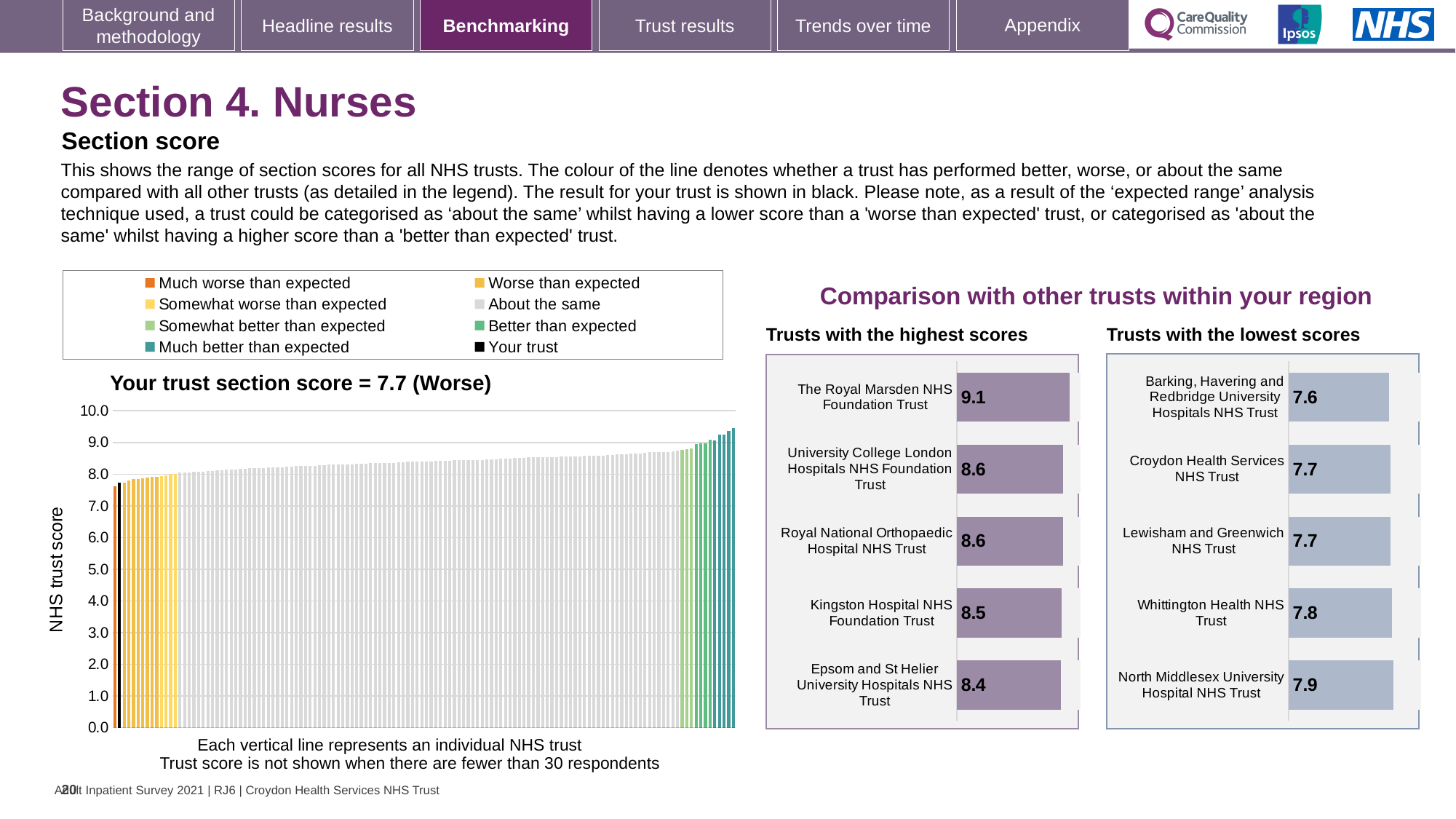
In the 'Trusts with the lowest scores' chart, which has the higher score, Whittington Health NHS Trust or Barking, Havering and Redbridge University Hospitals NHS Trust? Whittington Health NHS Trust In the 'Trusts with the lowest scores' chart, how many trusts are shown? 5 In the 'Trusts with the highest scores' chart, what is the score for The Royal Marsden NHS Foundation Trust? 9.1 In the 'Trusts with the highest scores' chart, which trust has the highest score? The Royal Marsden NHS Foundation Trust In the 'Your trust section score' chart, what is the label on the vertical axis? NHS trust score What kind of chart is the 'Your trust section score' chart? bar chart In the 'Your trust section score' chart, is the value of the tallest bar greater or less than 9.0? greater In the 'Trusts with the highest scores' chart, what is the difference between the scores of The Royal Marsden NHS Foundation Trust and Epsom and St Helier University Hospitals NHS Trust? 0.7 In the 'Your trust section score' chart, what is the section score for your trust? 7.7 In the 'Trusts with the lowest scores' chart, what is the score for Barking, Havering and Redbridge University Hospitals NHS Trust? 7.6 In the 'Your trust section score' chart, how many entries does the legend list? 8 In the 'Your trust section score' chart, do the values rise or fall from left to right? rise